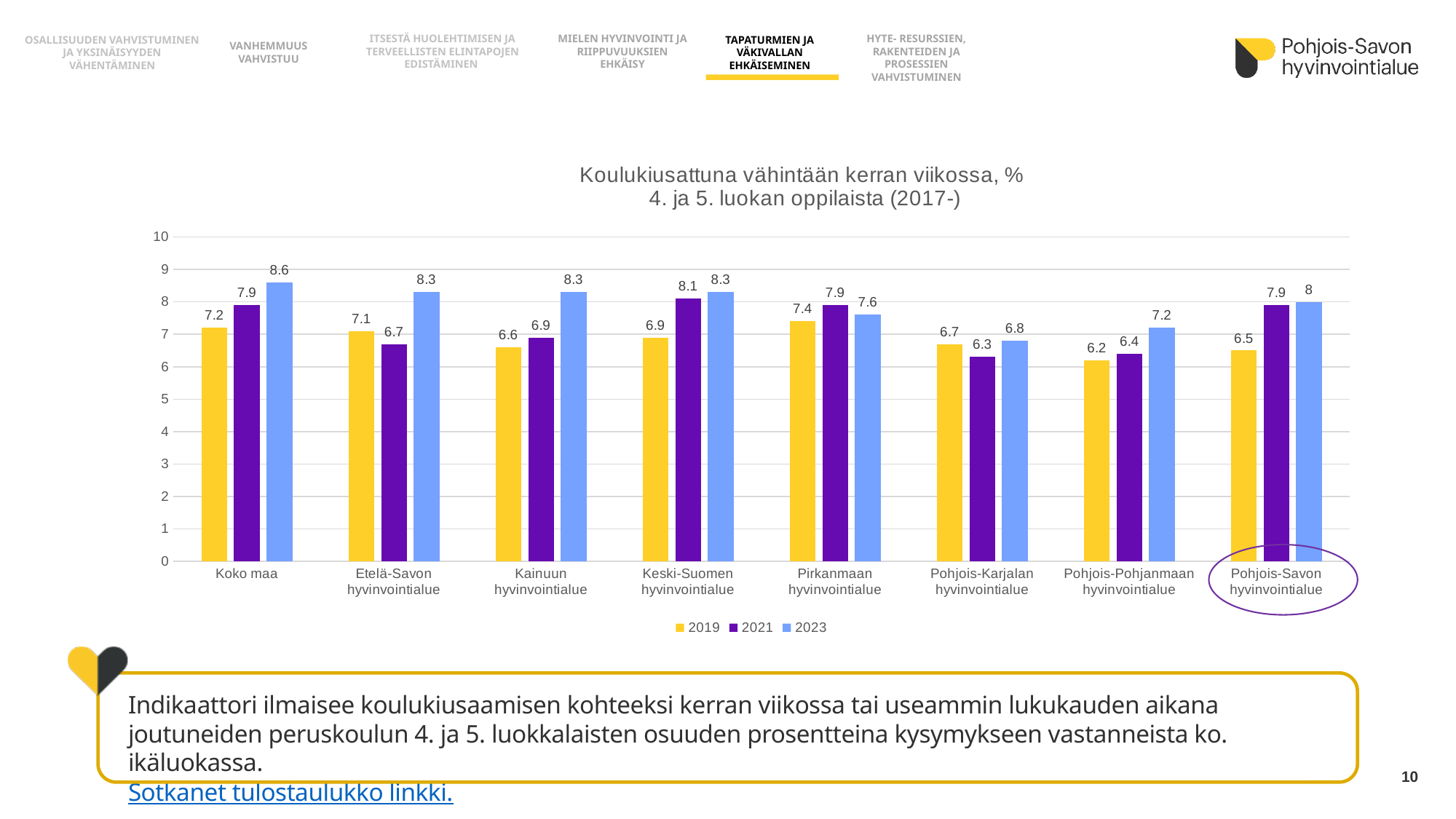
Which category has the highest 2023 value? Koko maa How many series does the legend list? 3 What is the 2023 value for Pohjois-Savon hyvinvointialue? 8 Which category has the lowest 2019 value? Pohjois-Pohjanmaan hyvinvointialue What is the difference between the 2023 and 2019 values for Pohjois-Savon hyvinvointialue? 1.5 What kind of chart is shown on the slide? Bar chart Which category has the lowest 2021 value? Pohjois-Karjalan hyvinvointialue What is the 2021 value for Keski-Suomen hyvinvointialue? 8.1 What is the 2019 value for Koko maa? 7.2 How many categories are shown on the x axis? 8 Which is larger for Pirkanmaan hyvinvointialue, the 2021 value or the 2023 value? 2021 Which series is shown in yellow in the legend? 2019